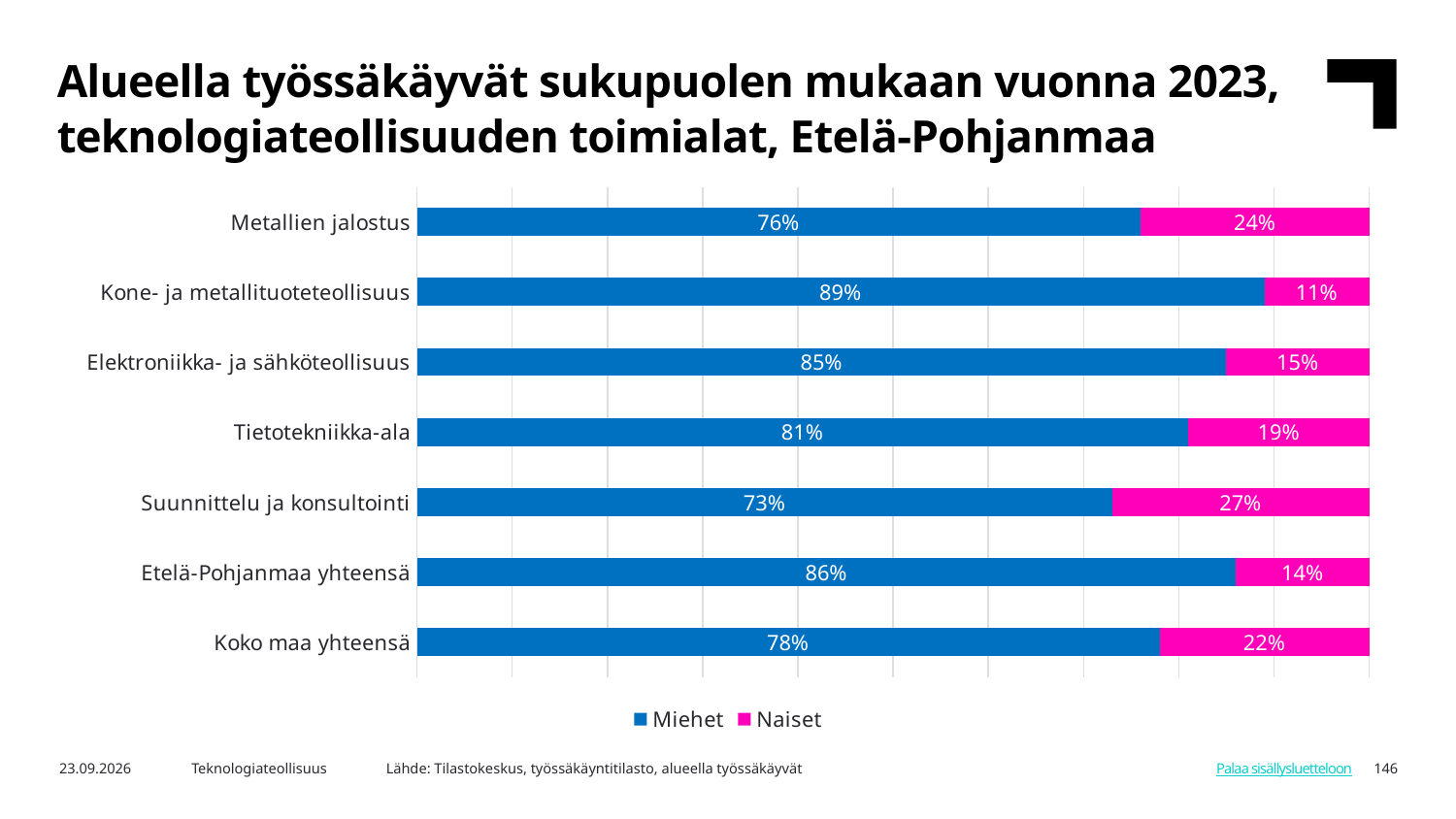
Which is larger: the Naiset value for Metallien jalostus or for Koko maa yhteensä? Metallien jalostus What is the Miehet value for Koko maa yhteensä? 78% What is the Naiset value for Suunnittelu ja konsultointi? 27% Which category has the lowest Miehet share? Suunnittelu ja konsultointi What is the difference between the Miehet values for Metallien jalostus and Tietotekniikka-ala? 5 percentage points What is the Naiset value for Etelä-Pohjanmaa yhteensä? 14% What kind of chart is shown on the slide? Stacked bar chart How many categories are shown on the chart? 7 Which category has the lowest Naiset share? Kone- ja metallituoteteollisuus What is the Miehet value for Kone- ja metallituoteteollisuus? 89% How many series does the legend list? 2 Which category has the highest Naiset share? Suunnittelu ja konsultointi